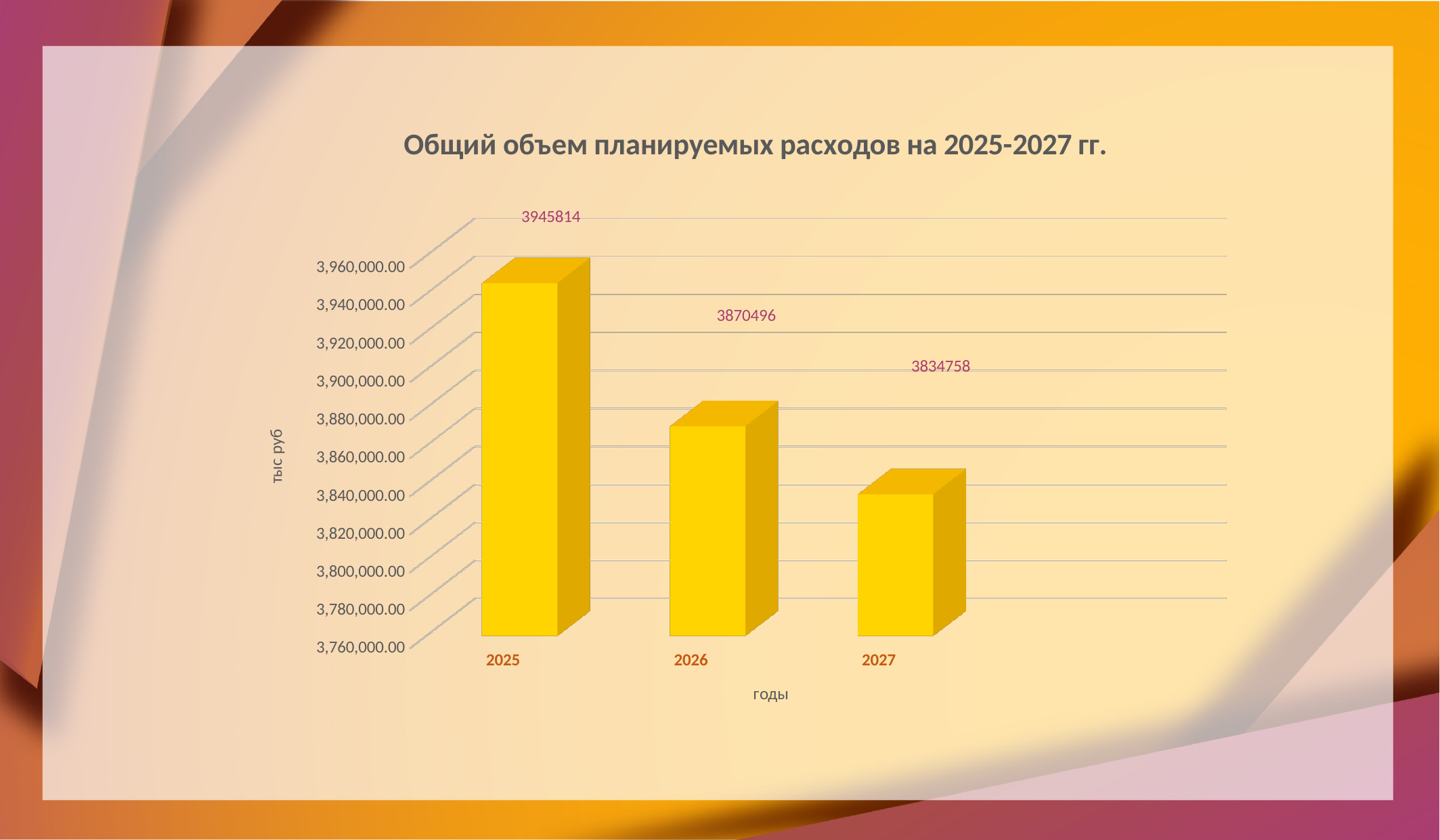
What is the value for 2026? 3870496 What is the difference between the values for 2025 and 2026? 75318 Which year has the lowest planned expenditure? 2027 What is the value for 2027? 3834758 How many years are shown on the chart? 3 Which year has the highest planned expenditure? 2025 Do the values rise or fall from 2025 to 2027? fall What kind of chart is shown on the slide? bar chart Is the value for 2026 greater or less than 3,860,000.00? greater What is the value for 2025? 3945814 Which is larger, the value for 2026 or the value for 2027? 2026 What is the difference between the values for 2026 and 2027? 35738